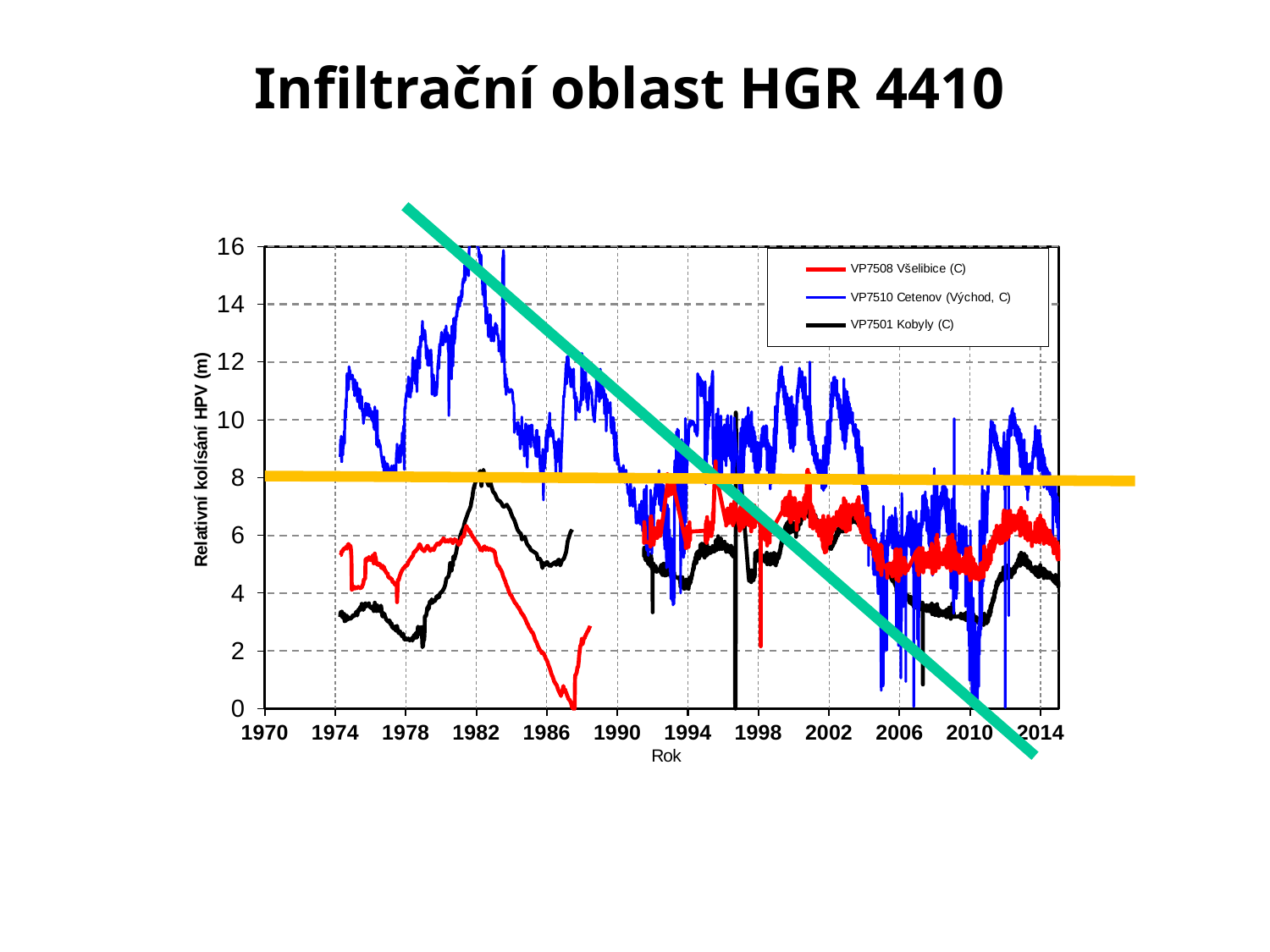
Around 1980, which series has the higher value: VP7510 Cetenov (Východ, C) or VP7508 Všelibice (C)? VP7510 Cetenov (Východ, C) Is the value of the VP7508 Všelibice (C) series around 1987 greater or less than 2? less Around 2008, which series has the lower value: VP7501 Kobyly (C) or VP7508 Všelibice (C)? VP7501 Kobyly (C) What is the title of the slide? Infiltrační oblast HGR 4410 Which series reaches the highest values on the chart? VP7510 Cetenov (Východ, C) Is the value of the VP7510 Cetenov (Východ, C) series at its peak around 1982 greater or less than 14? greater How many series does the chart legend list? 3 Which colour is used for the VP7510 Cetenov (Východ, C) series? blue What kind of chart is shown on the slide? line chart Does the VP7508 Všelibice (C) series rise or fall between 1983 and 1987? fall Is the value of the VP7501 Kobyly (C) series around 1978 greater or less than 4? less